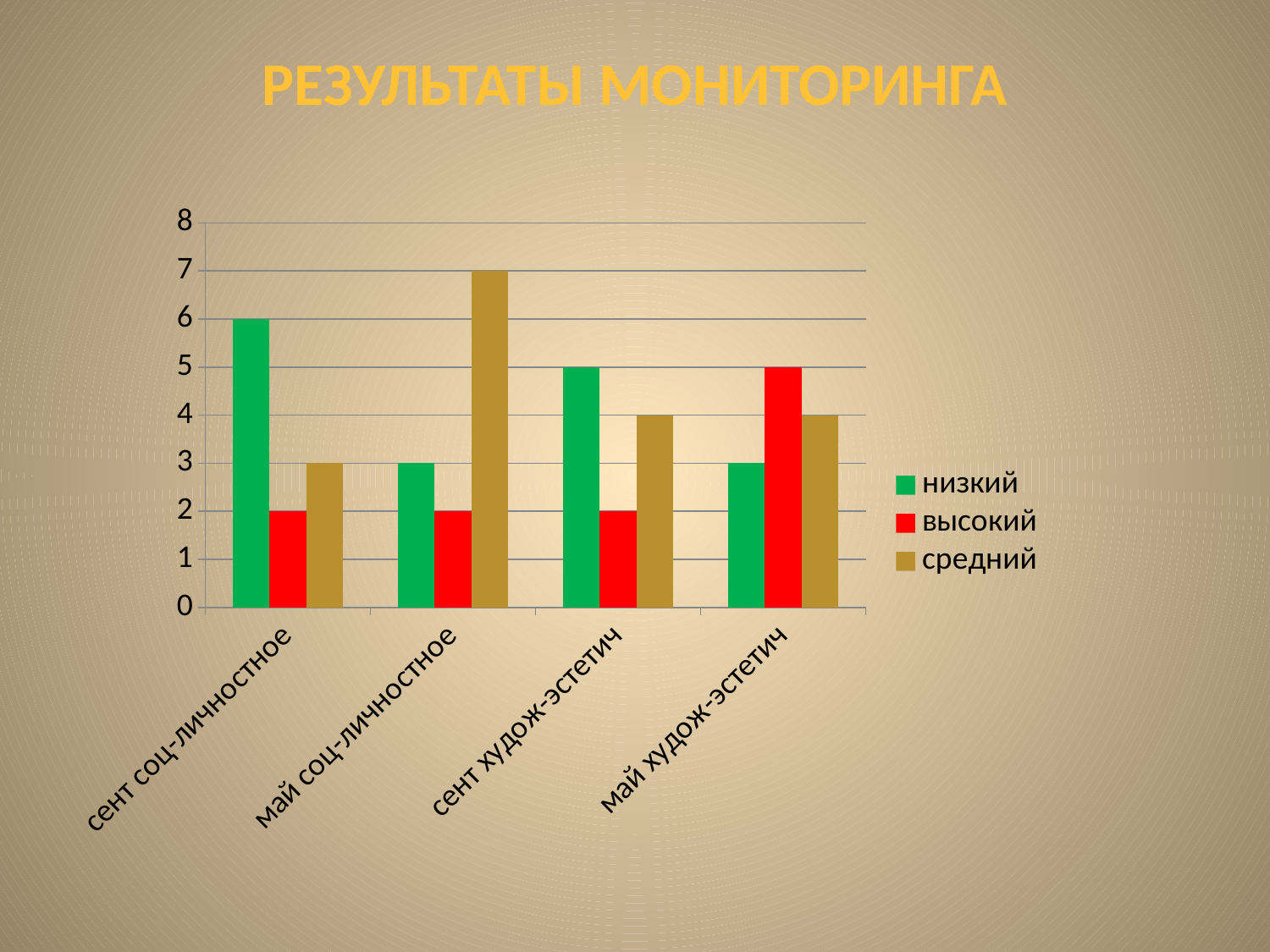
Which category has the lowest value for низкий? май соц-личностное and май худож-эстетич (tied at 3) What kind of chart is shown on the slide? bar chart What is the difference between низкий for сент соц-личностное and низкий for май соц-личностное? 3 How many series does the legend list? 3 Is the value of средний for май соц-личностное greater or less than 5? greater Which is larger: высокий for сент худож-эстетич or высокий for май худож-эстетич? май худож-эстетич What is the value of низкий for сент соц-личностное? 6 What is the value of средний for май соц-личностное? 7 What is the value of высокий for май худож-эстетич? 5 What is the title of the chart? РЕЗУЛЬТАТЫ МОНИТОРИНГА Which category has the highest value for средний? май соц-личностное How many categories are shown on the x axis? 4